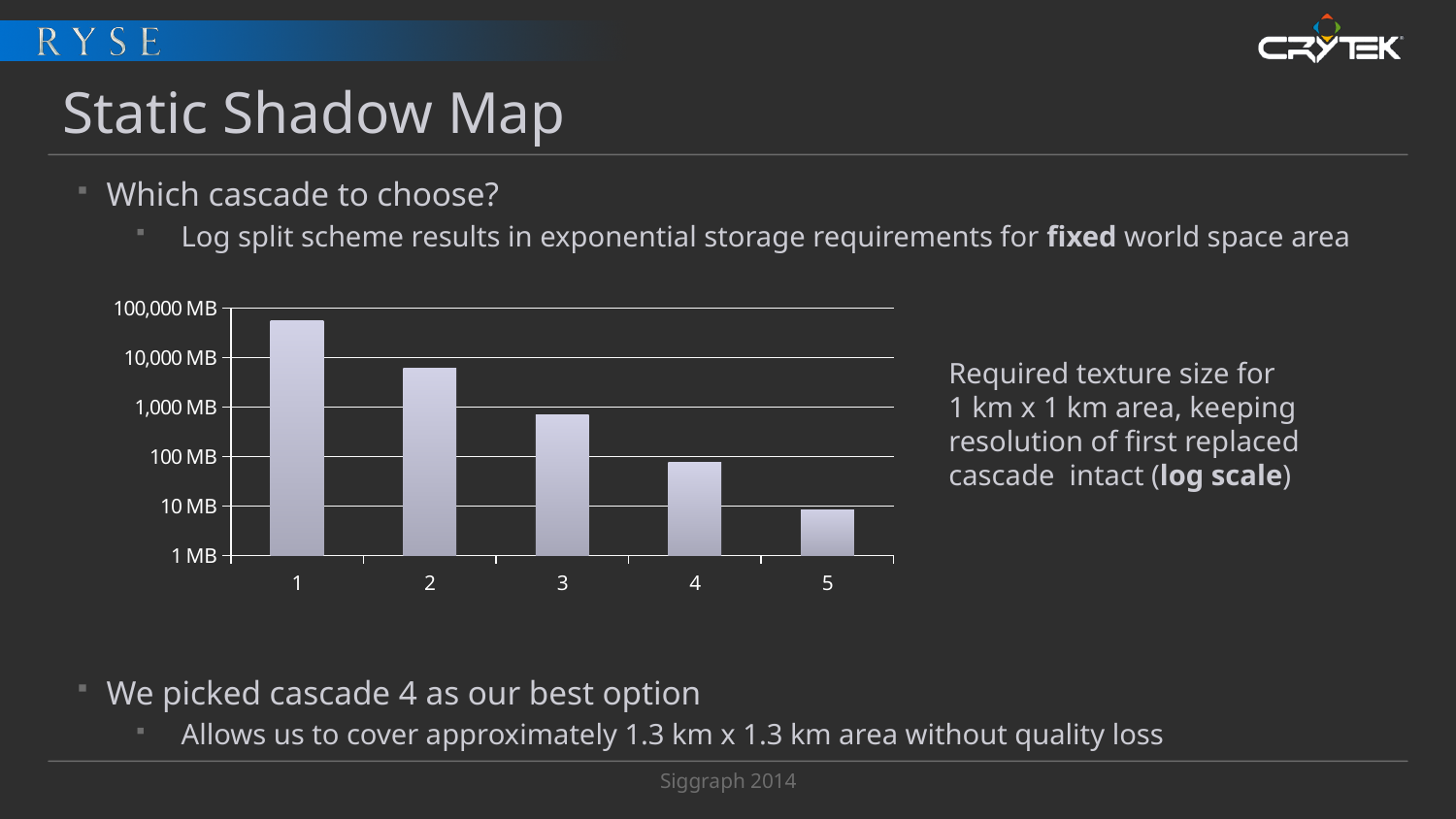
What kind of chart is shown on the slide? bar chart Which has a larger required texture size, cascade 2 or cascade 4? cascade 2 Is the value for cascade 4 greater or less than 100 MB? less Do the bar values rise or fall as the cascade number increases along the x axis? fall How many cascades (categories) are plotted on the x axis of the chart? 5 Is the value for cascade 1 greater or less than 10,000 MB? greater Is the value for cascade 2 greater or less than 10,000 MB? less Which cascade has the lowest required texture size in the chart? 5 Which cascade has the highest required texture size in the chart? 1 What is the highest tick label shown on the y axis of the chart? 100,000 MB